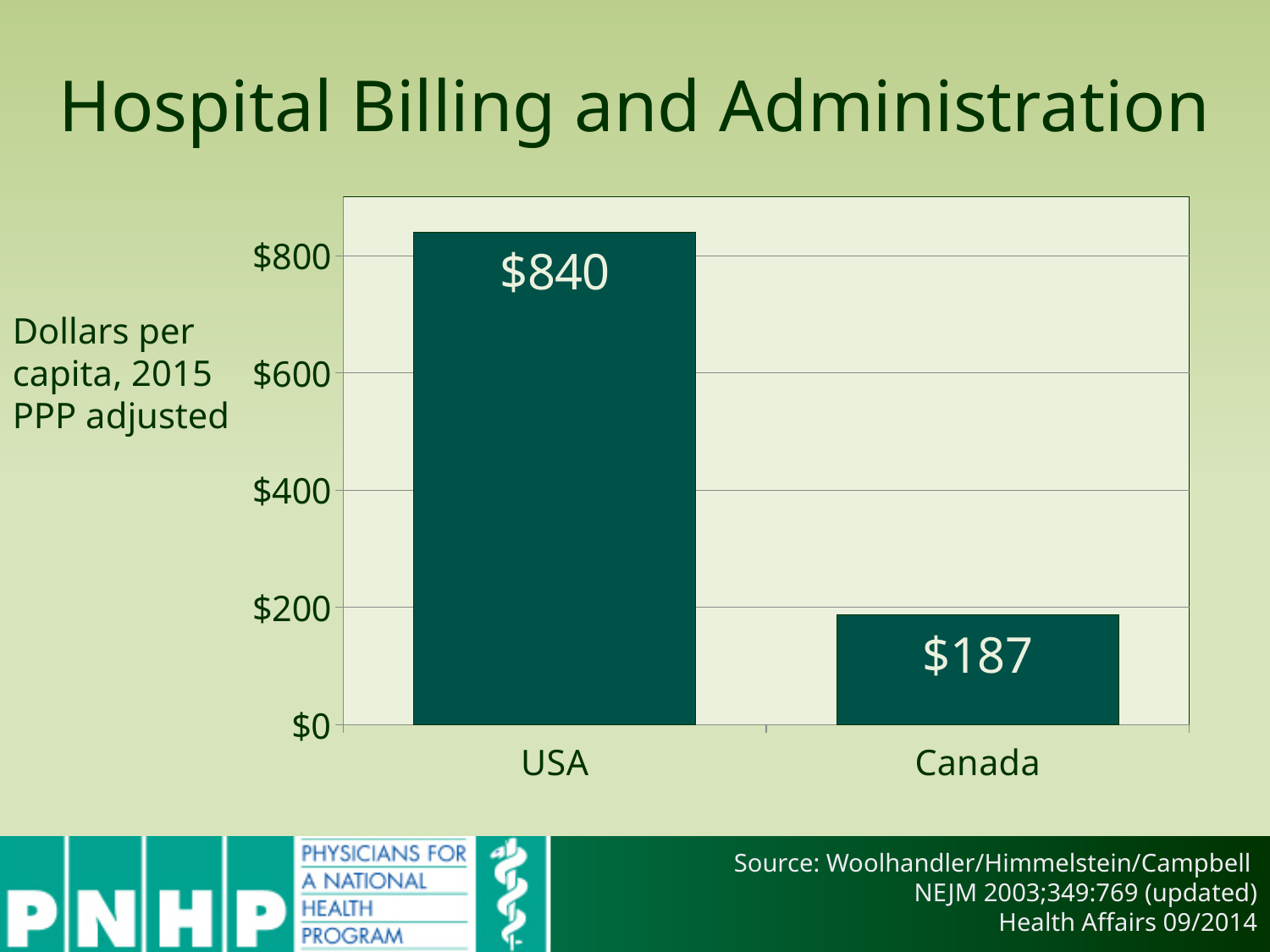
What is the value for Canada? $187 Is the value for Canada greater or less than $200? less What is the title of the slide? Hospital Billing and Administration How many categories are shown on the x axis? 2 What is the difference between the values for USA and Canada? $653 What kind of chart is shown on the slide? bar chart Which is larger, the value for USA or the value for Canada? USA Is the value for USA greater or less than $800? greater Which category has the lowest value? Canada What unit is described in the label to the left of the chart? Dollars per capita, 2015 PPP adjusted What is the value for USA? $840 Which category has the highest value? USA